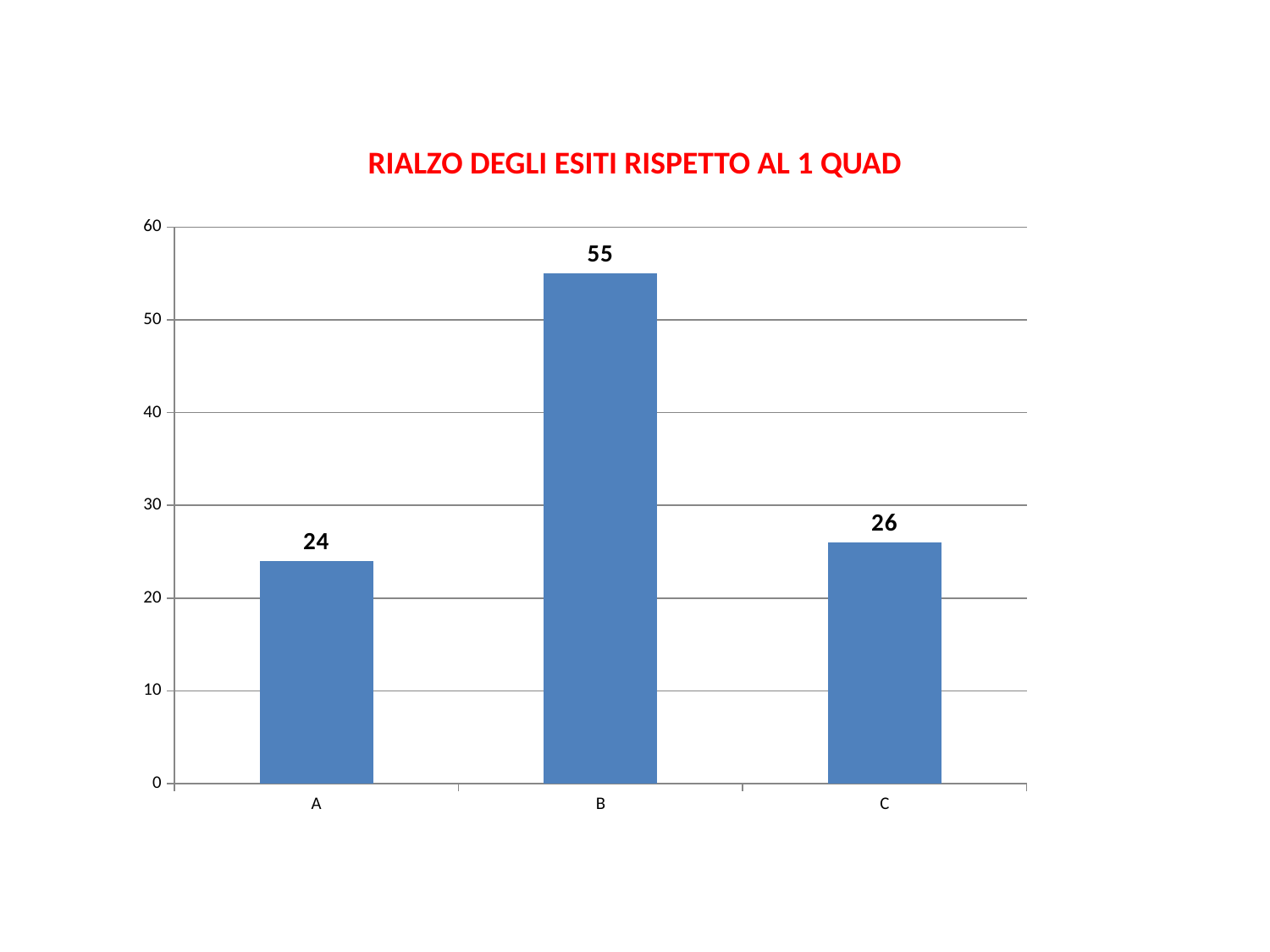
What is the title of the chart? RIALZO DEGLI ESITI RISPETTO AL 1 QUAD What is the difference between the values for B and A? 31 What kind of chart is shown on the slide? bar chart Which is larger, the value for B or the value for C? B How many categories are shown on the x axis? 3 Which category has the lowest value? A What is the value for category C? 26 What is the value for category B? 55 What is the value for category A? 24 Is the value for B greater or less than 50? greater Which category has the highest value? B What is the difference between the values for C and A? 2